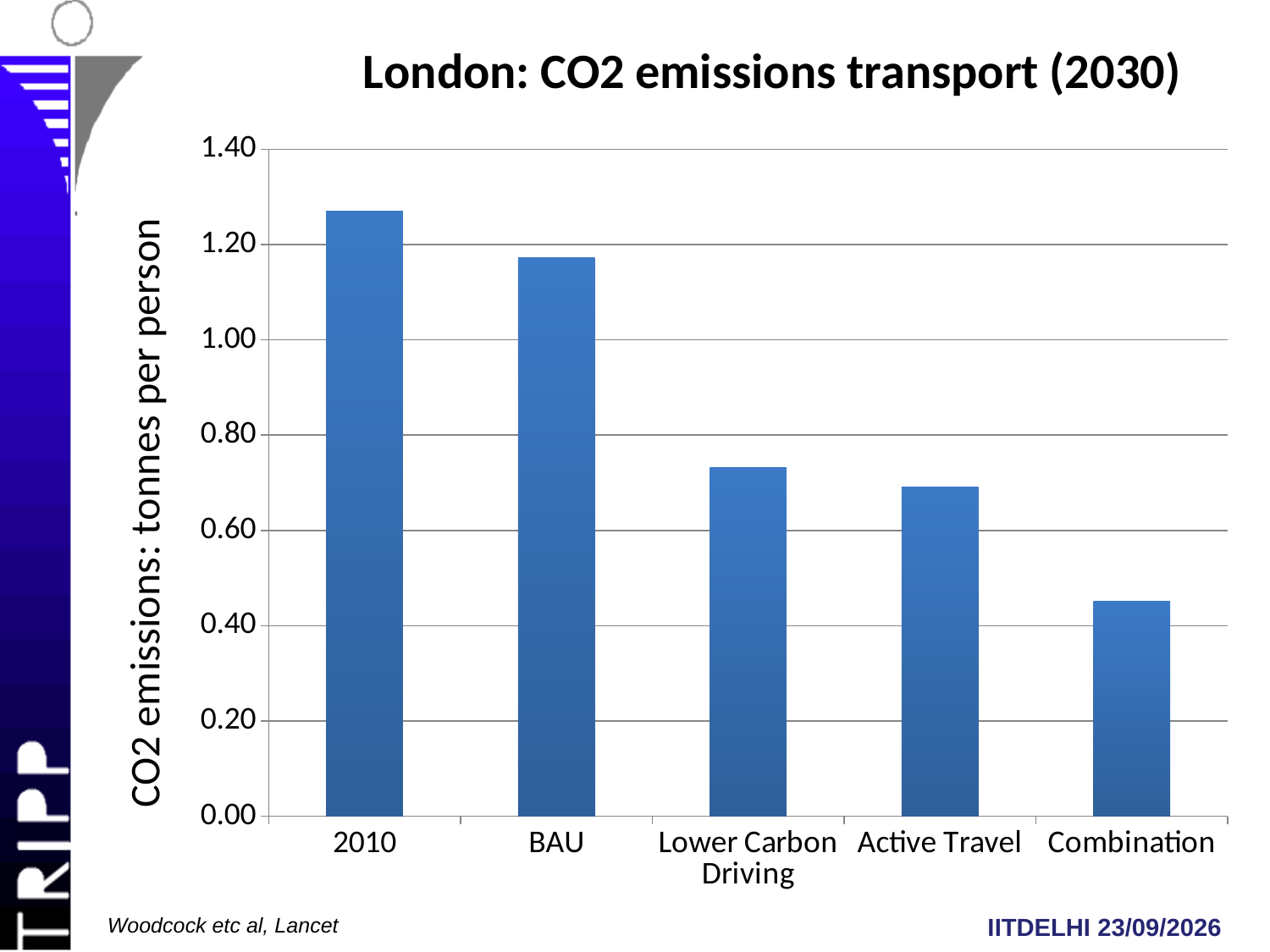
Is the value for Lower Carbon Driving greater or less than 0.80? less Which is larger, the value for BAU or the value for Active Travel? BAU Is the value for 2010 greater or less than 1.20? greater What type of chart is shown on the slide? bar chart Which category has the highest CO2 emissions? 2010 What is the label of the vertical axis? CO2 emissions: tonnes per person Is the value for Combination greater or less than 0.40? greater What is the title of the chart? London: CO2 emissions transport (2030) How many categories are shown on the x axis? 5 Do the values generally rise or fall from left to right along the x axis? fall Which category has the lowest CO2 emissions? Combination